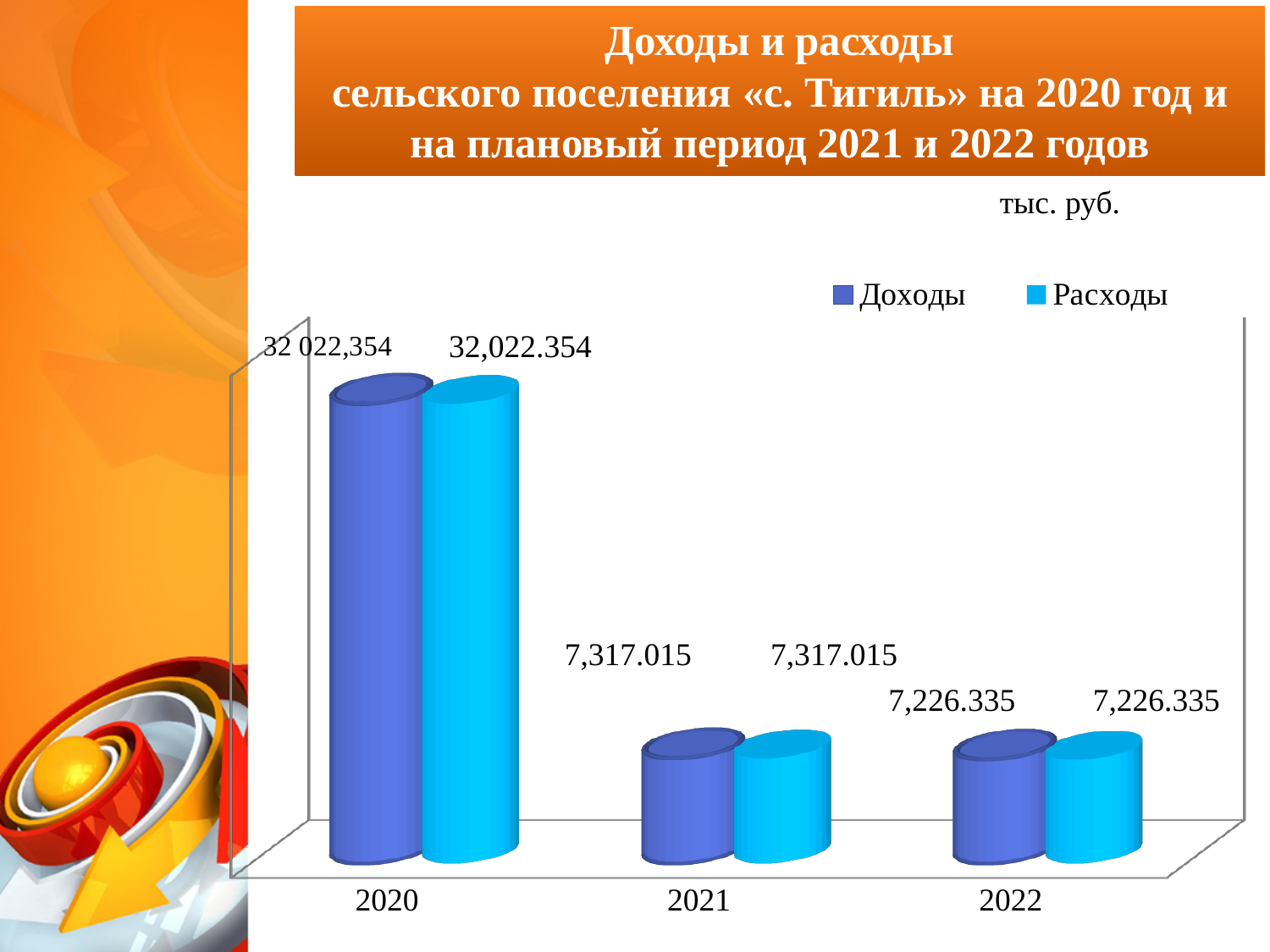
What is the value of Доходы for 2021? 7,317.015 How many series does the legend list? 2 In which year is Доходы the highest? 2020 What is the difference between Доходы in 2021 and Доходы in 2022? 90.680 Do the Расходы values rise or fall from 2020 to 2022? fall What is the value of Расходы for 2020? 32,022.354 What is the value of Расходы for 2022? 7,226.335 How many years are shown on the x axis? 3 What kind of chart is shown on the slide? bar chart What unit is indicated above the chart? тыс. руб. Which is larger: Расходы in 2021 or Расходы in 2022? 2021 In which year is Расходы the lowest? 2022